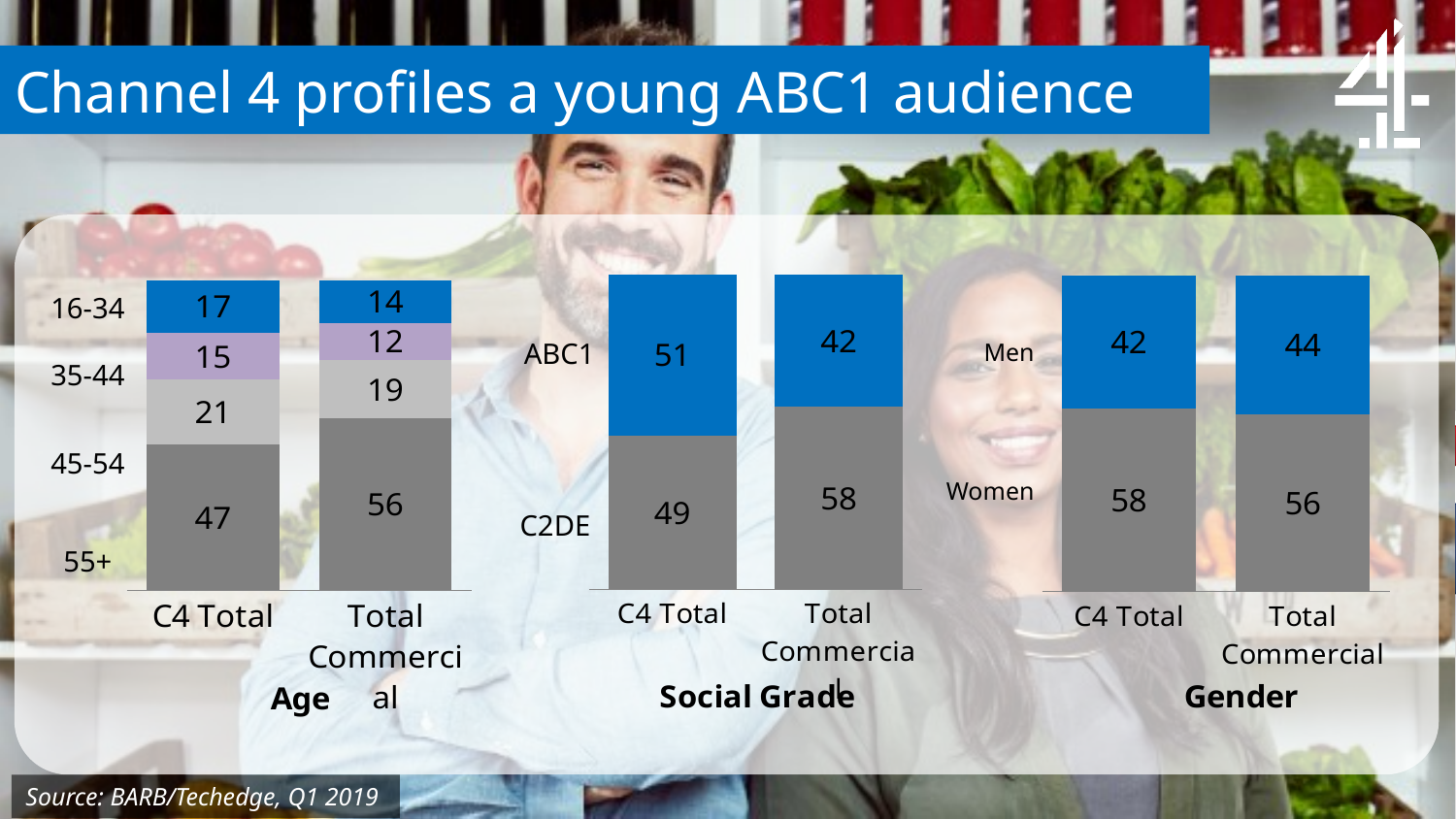
In the Social Grade chart, what is the ABC1 value for C4 Total? 51 What is the title of the slide? Channel 4 profiles a young ABC1 audience In the Gender chart, what is the difference between the Women value and the Men value for C4 Total? 16 In the Age chart, which bar has the larger 55+ segment, C4 Total or Total Commercial? Total Commercial In the Social Grade chart, what is the difference between the ABC1 value for C4 Total and the ABC1 value for Total Commercial? 9 In the Age chart, how many age groups are shown in each stacked bar? 4 What kind of chart is the Gender chart? Stacked bar chart In the Age chart, what is the value for the 16-34 segment of the Total Commercial bar? 14 In the Age chart, what is the value for the 55+ segment of the C4 Total bar? 47 In the Age chart, what is the total of the C4 Total stacked bar? 100 In the Gender chart, what is the Women value for Total Commercial? 56 In the Age chart, which age group is the largest segment of the C4 Total bar? 55+